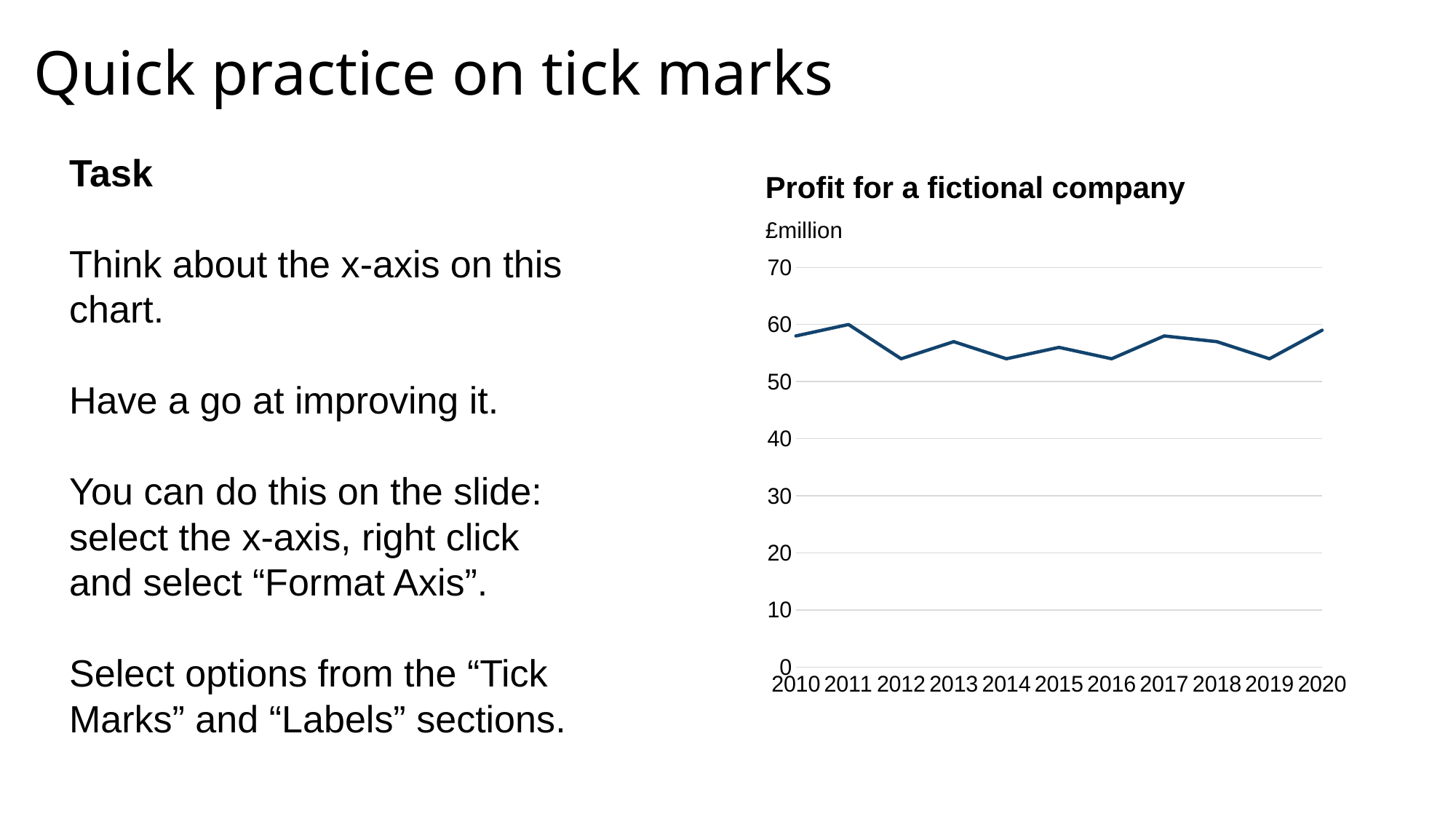
Is the value for 2019 greater or less than 40? greater What kind of chart is shown on the slide? line chart How many years are plotted on the x-axis of the chart? 11 What unit is shown above the y-axis of the chart? £million Does the value rise or fall from 2011 to 2012? fall Which year has the larger value, 2016 or 2017? 2017 Which year has the larger value, 2019 or 2020? 2020 Is the value for 2012 greater or less than 60? less Is the value for 2010 greater or less than 50? greater What is the title of the chart? Profit for a fictional company Which year has the larger value, 2011 or 2012? 2011